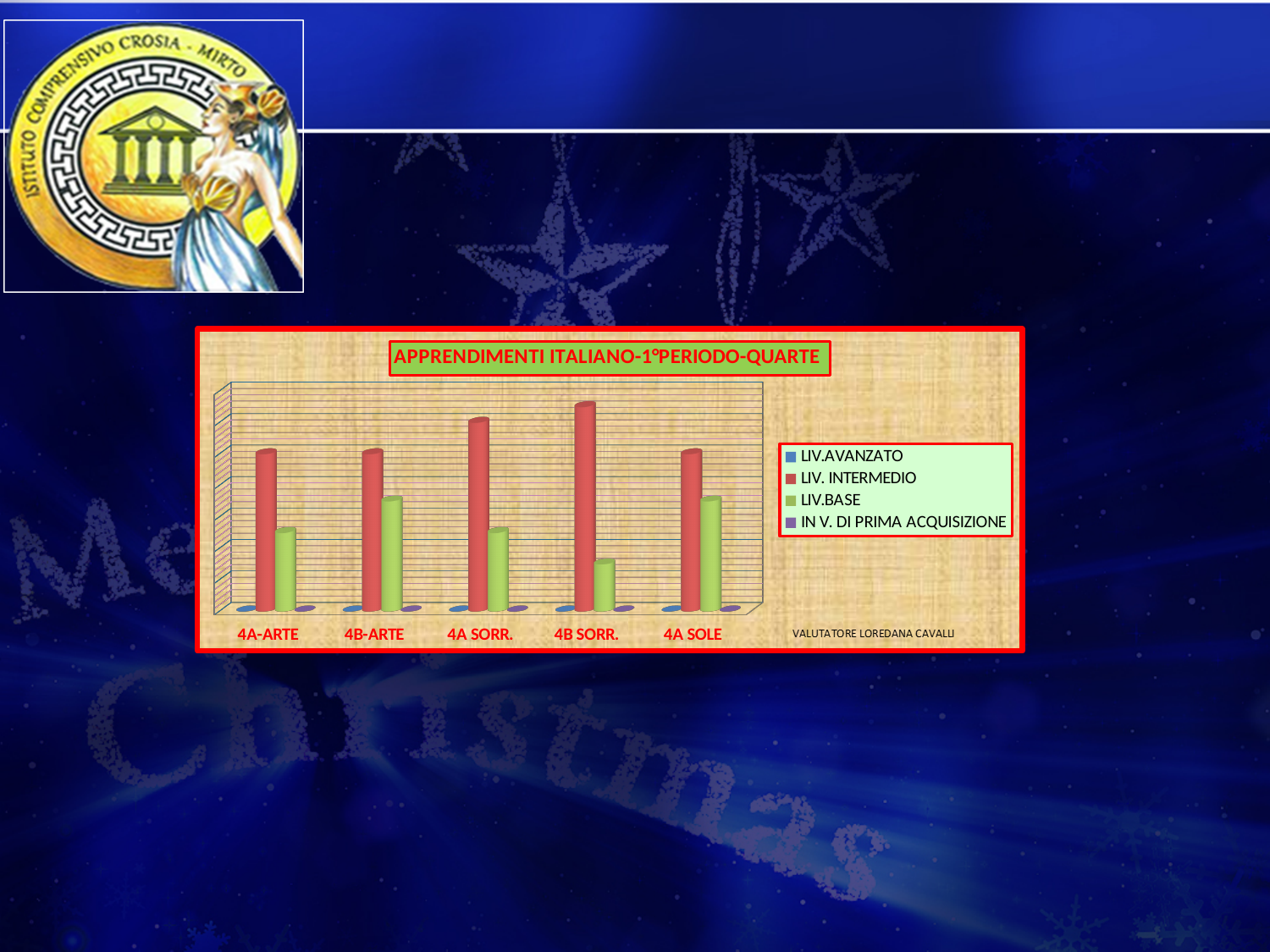
Which class has the larger LIV.BASE bar: 4A SORR. or 4B SORR.? 4A SORR. Which class has the larger LIV.BASE bar: 4A-ARTE or 4B-ARTE? 4B-ARTE For 4A-ARTE, which is larger: LIV. INTERMEDIO or LIV.BASE? LIV. INTERMEDIO How many classes (categories) are shown along the x axis of the chart? 5 Which legend entry is shown in green? LIV.BASE How many series does the chart legend list? 4 Which class has the lowest LIV.BASE bar? 4B SORR. What is the title of the chart? APPRENDIMENTI ITALIANO-1°PERIODO-QUARTE What kind of chart is shown on the slide? bar chart Which class has the highest LIV. INTERMEDIO bar? 4B SORR.